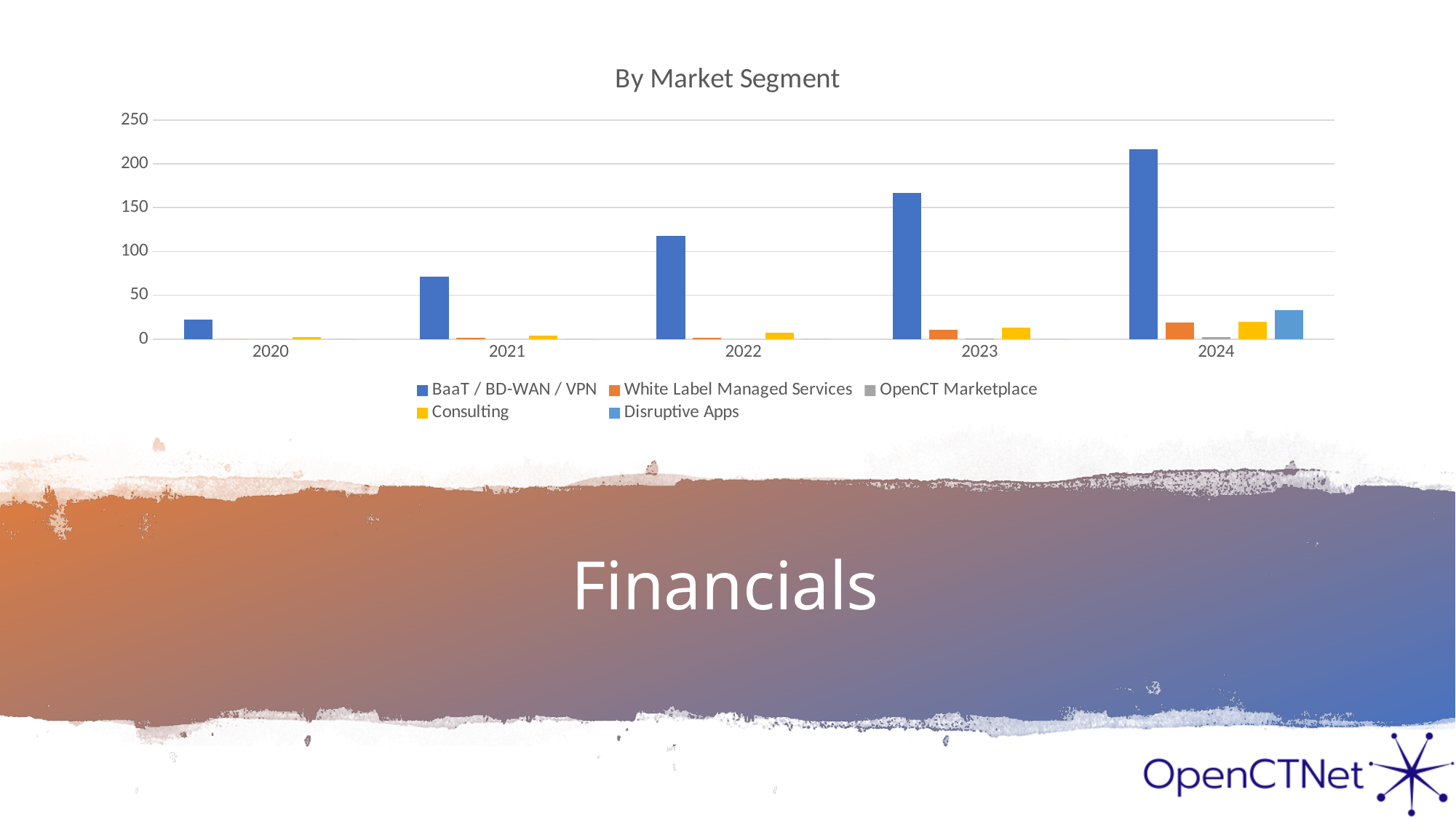
Is the BaaT / BD-WAN / VPN value for 2024 greater or less than 200? greater Is the BaaT / BD-WAN / VPN value for 2022 greater or less than 100? greater In which year is the BaaT / BD-WAN / VPN value highest? 2024 Which series is shown in dark blue in the legend? BaaT / BD-WAN / VPN In 2024, which is larger: Disruptive Apps or Consulting? Disruptive Apps What type of chart is shown on the slide? bar chart In which year is the BaaT / BD-WAN / VPN value lowest? 2020 Do the BaaT / BD-WAN / VPN values rise or fall from 2020 to 2024? rise How many years are shown along the x axis? 5 Is the BaaT / BD-WAN / VPN value for 2021 greater or less than 100? less What is the title of the chart? By Market Segment How many series does the legend list? 5